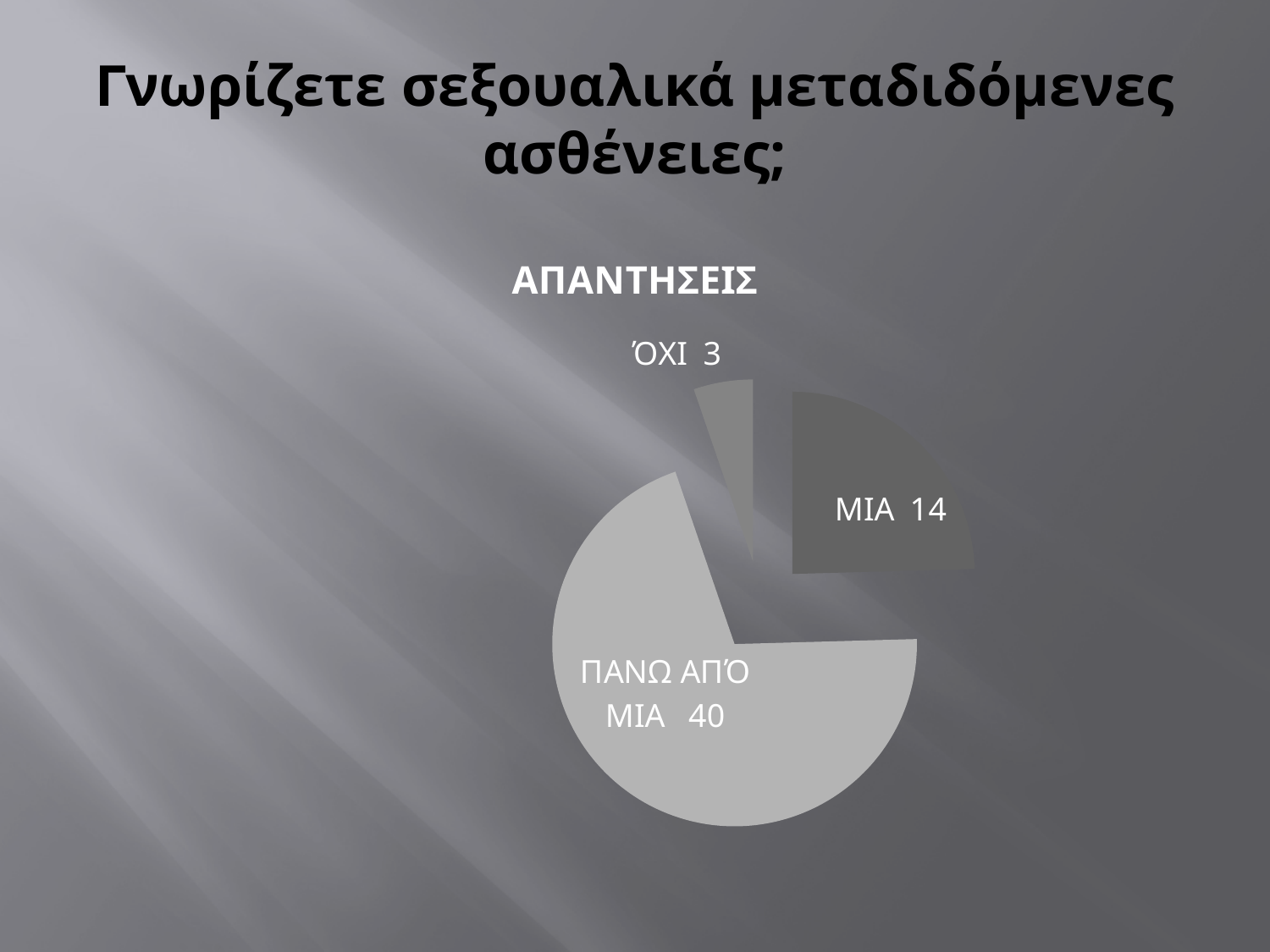
Which category has the largest slice? ΠΑΝΩ ΑΠΌ ΜΙΑ What is the difference between the values for ΜΙΑ and ΌΧΙ? 11 What is the title of the chart? ΑΠΑΝΤΗΣΕΙΣ Which is larger, the value for ΜΙΑ or the value for ΌΧΙ? ΜΙΑ Which category has the smallest slice? ΌΧΙ What is the difference between the values for ΠΑΝΩ ΑΠΌ ΜΙΑ and ΜΙΑ? 26 What kind of chart is shown on the slide? pie chart What is the value for ΠΑΝΩ ΑΠΌ ΜΙΑ? 40 What is the value for ΌΧΙ? 3 What is the value for ΜΙΑ? 14 How many slices does the pie chart have? 3 What is the total of all the slices in the pie chart? 57